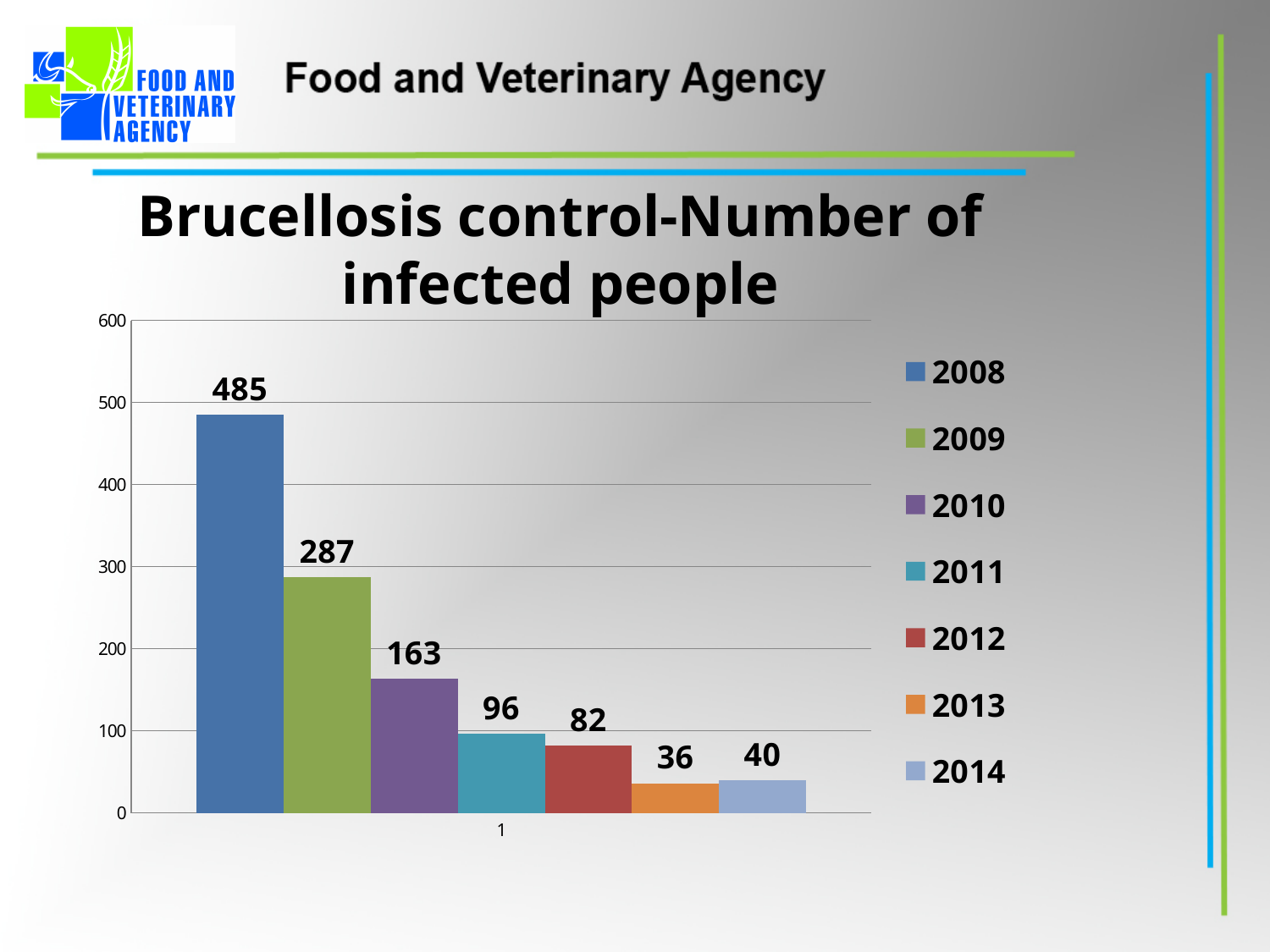
Which year has more infected people, 2013 or 2014? 2014 Which year has the highest number of infected people? 2008 Which year has the lowest number of infected people? 2013 What is the number of infected people for 2011? 96 Do the values generally rise or fall from 2008 to 2013? fall What is the number of infected people for 2008? 485 What is the difference between the number of infected people in 2008 and 2009? 198 How many series does the legend list? 7 What is the difference between the number of infected people in 2010 and 2012? 81 What is the number of infected people for 2013? 36 What kind of chart is shown on the slide? bar chart What is the title of the chart? Brucellosis control-Number of infected people